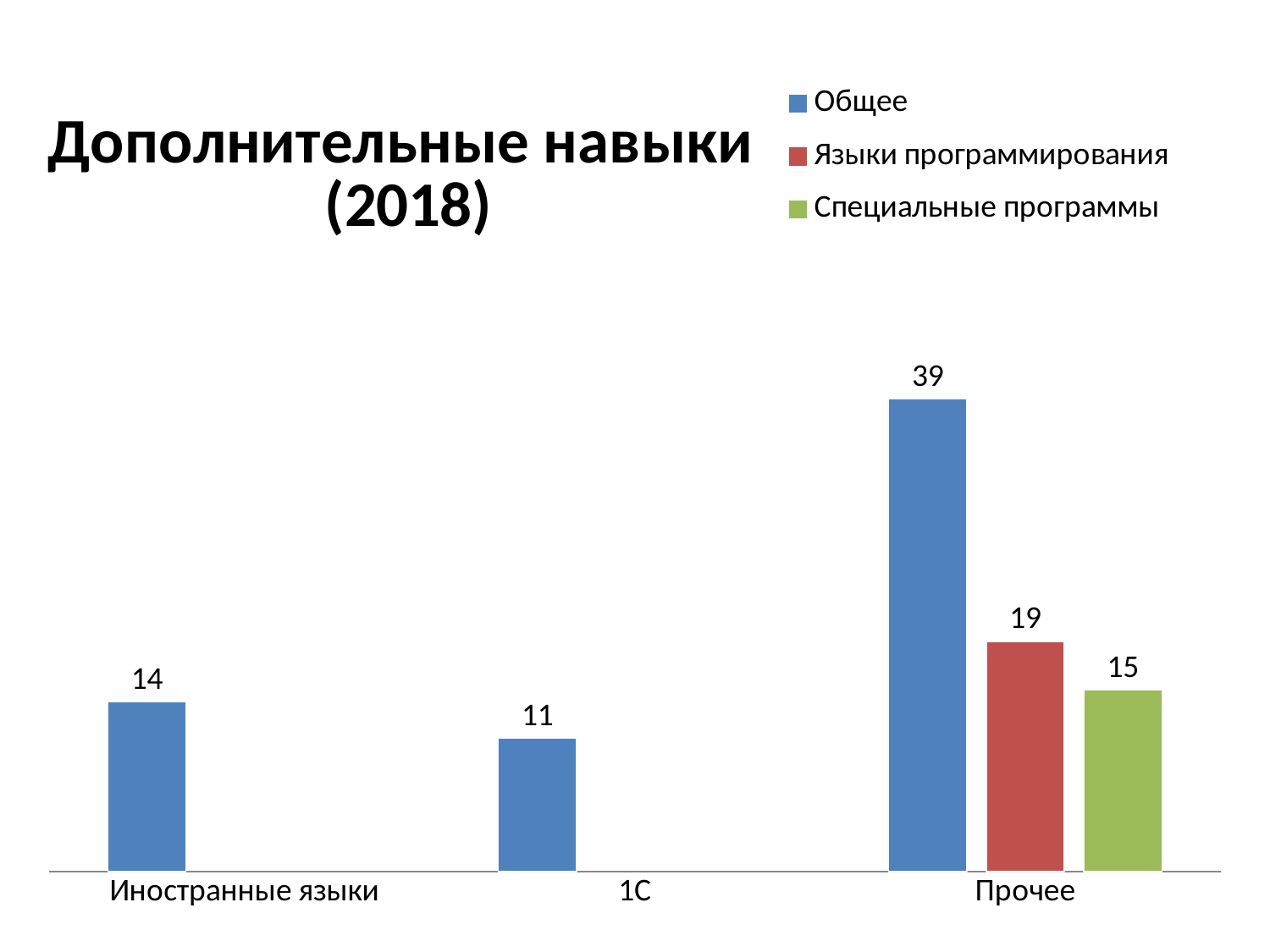
Which category has the lowest value in the Общее series? 1С What is the value of the Специальные программы series for Прочее? 15 What is the value of the Общее series for 1С? 11 How many series does the legend list? 3 What is the value of the Языки программирования series for Прочее? 19 How many categories are shown on the x axis? 3 Which is larger for Прочее: Языки программирования or Специальные программы? Языки программирования What type of chart is shown on the slide? Bar chart Which category has the highest value in the Общее series? Прочее What is the difference between the Общее value for Прочее and the Общее value for Иностранные языки? 25 What is the value of the Общее series for Прочее? 39 What is the value of the Общее series for Иностранные языки? 14